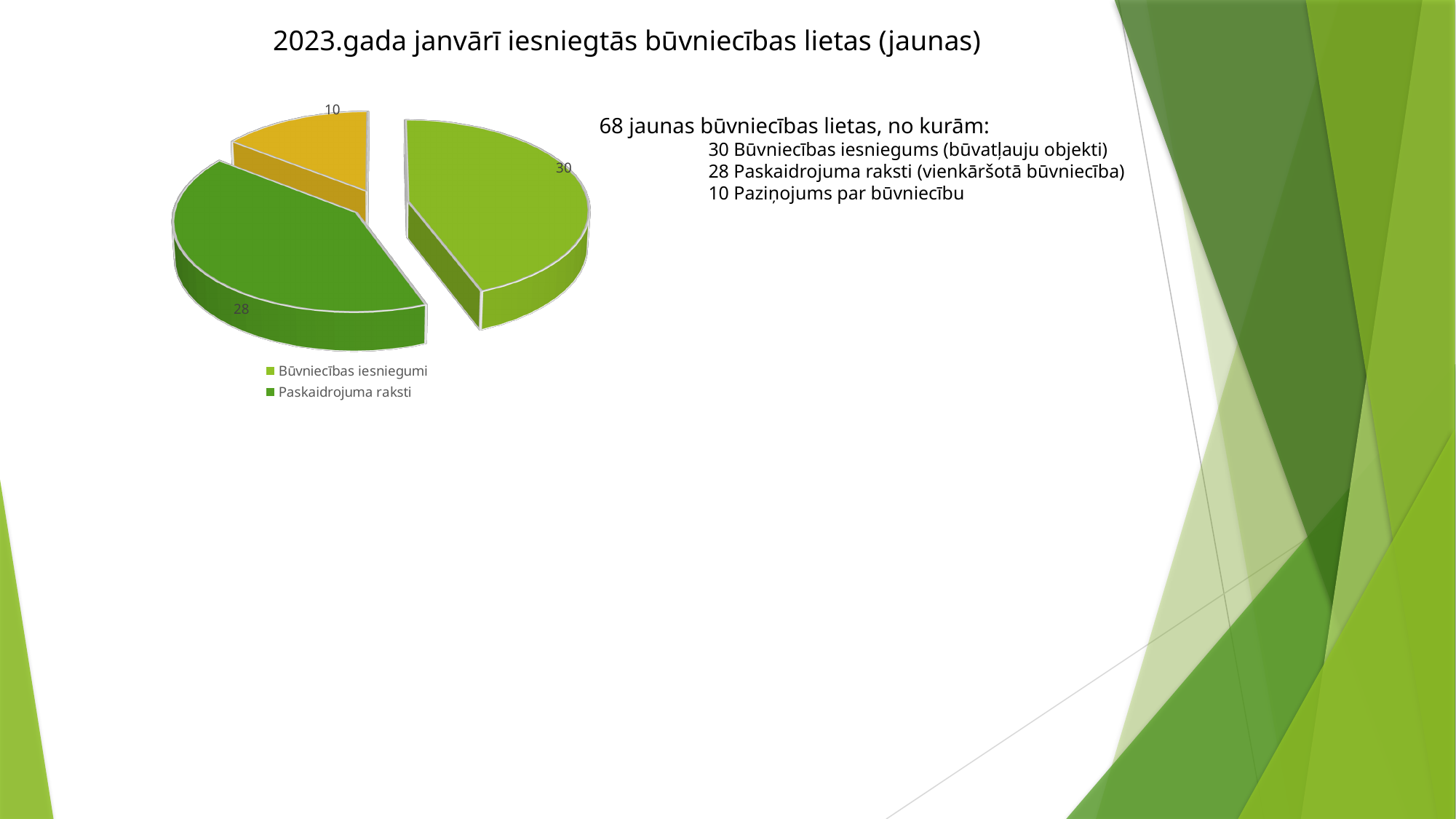
Which slice of the pie chart has the smallest value? the yellow slice (10) What is the value of the yellow slice of the pie chart? 10 What is the difference between the Paskaidrojuma raksti slice and the yellow slice? 18 How many entries does the chart legend list? 2 How many slices does the pie chart have? 3 What is the value of the Paskaidrojuma raksti slice? 28 What is the title of the slide containing the pie chart? 2023.gada janvārī iesniegtās būvniecības lietas (jaunas) What is the difference between the Būvniecības iesniegumi slice and the Paskaidrojuma raksti slice? 2 Which slice of the pie chart has the largest value? Būvniecības iesniegumi What kind of chart is shown on the slide? pie chart Which is larger, the Būvniecības iesniegumi slice or the yellow slice? Būvniecības iesniegumi What is the value of the Būvniecības iesniegumi slice? 30